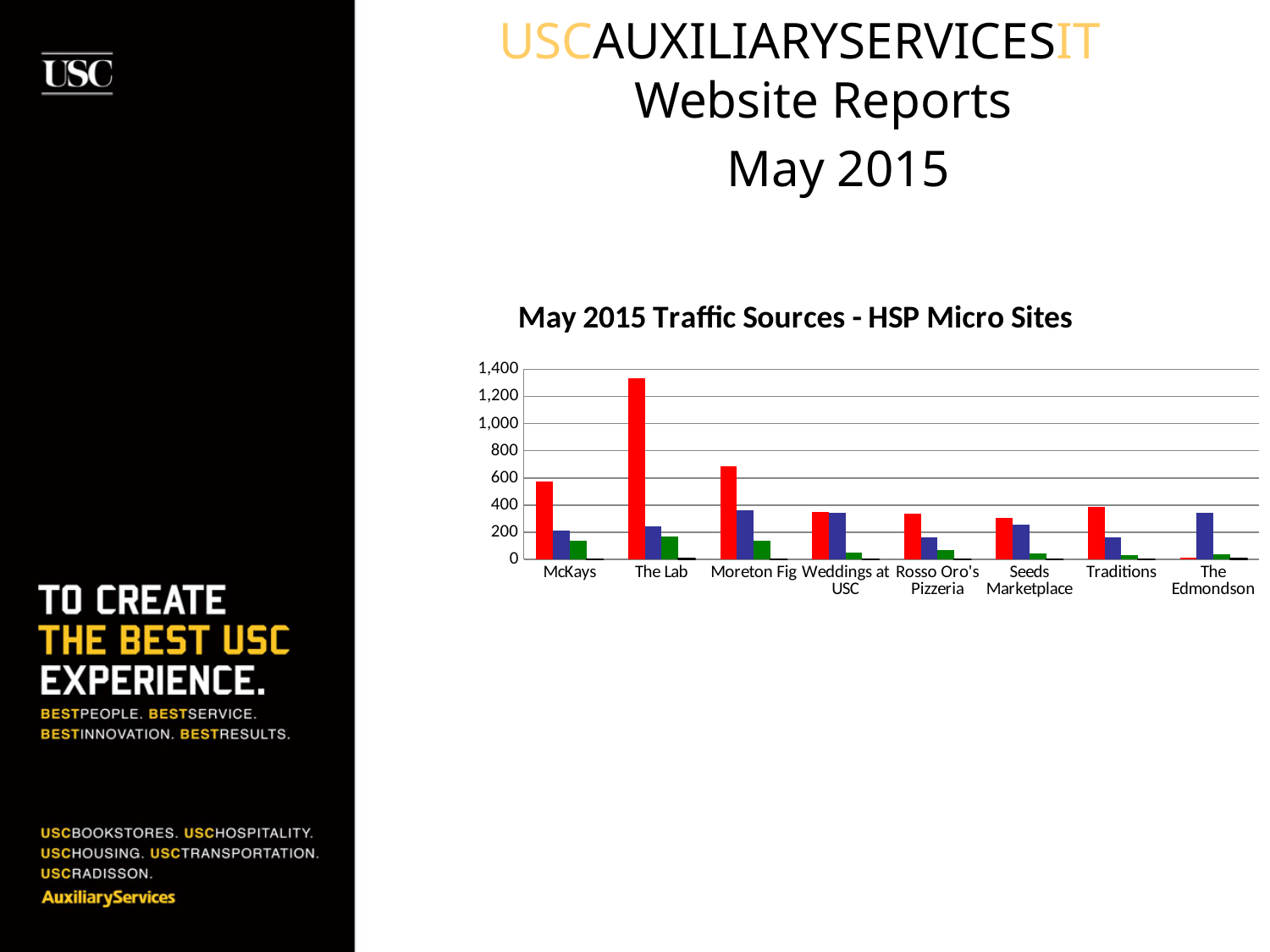
Which has the larger blue bar, The Lab or Moreton Fig? Moreton Fig How many micro sites (categories) are shown on the x axis of the chart? 8 What kind of chart is shown on the slide? bar chart Which micro site has the tallest red bar in the chart? The Lab Which has the larger red bar, McKays or Traditions? McKays What is the title of the chart? May 2015 Traffic Sources - HSP Micro Sites Is the red bar for McKays greater or less than 400? greater Is the red bar for Weddings at USC greater or less than 400? less Is the red bar for Moreton Fig greater or less than 600? greater Which micro site has the shortest red bar in the chart? The Edmondson